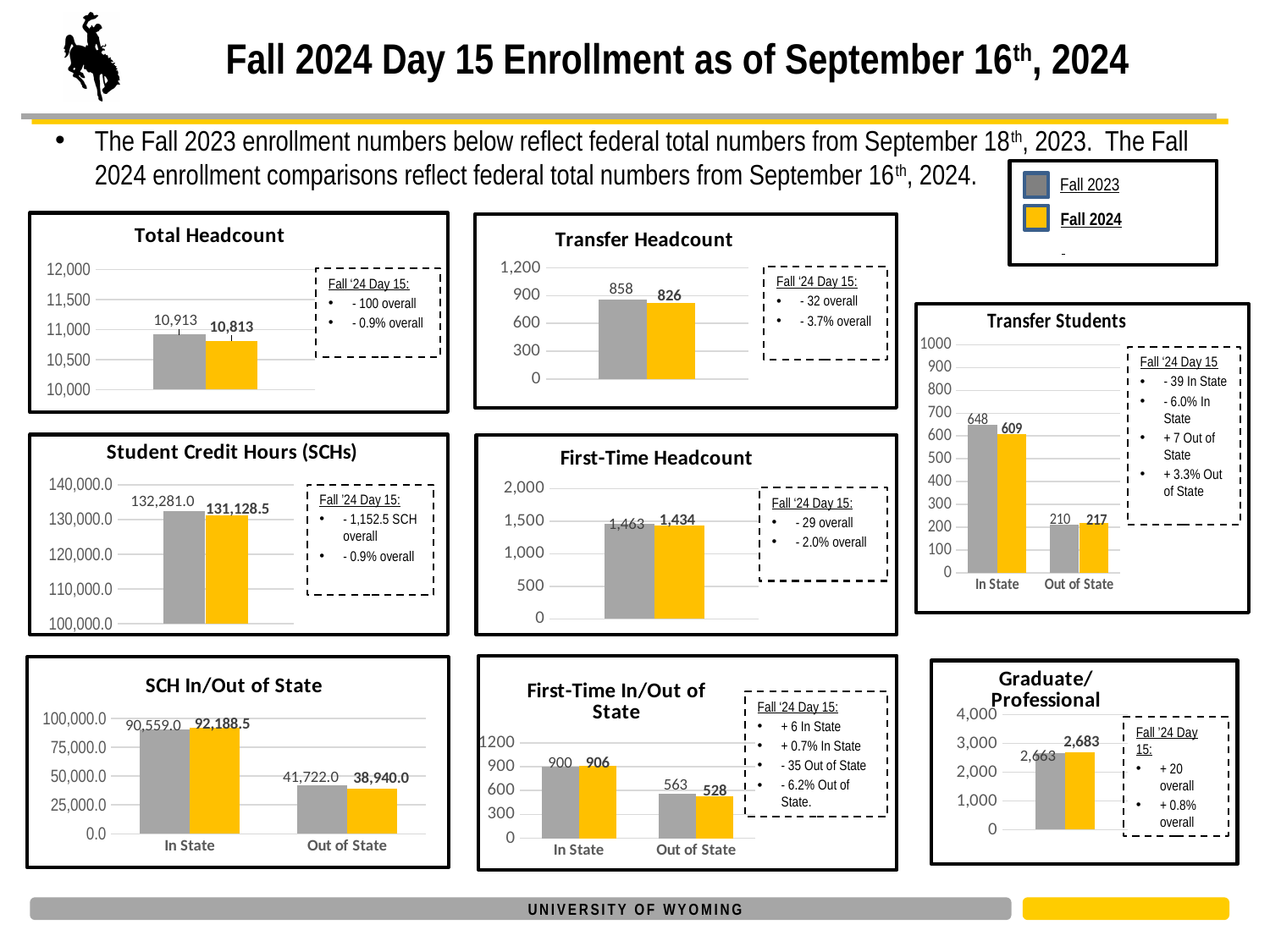
What type of chart is the Total Headcount chart? Bar chart In the SCH In/Out of State chart, what is the Fall 2024 value for In State? 92,188.5 In the Student Credit Hours (SCHs) chart, what is the difference between the Fall 2023 and Fall 2024 values? 1,152.5 In the Transfer Headcount chart, what is the value for Fall 2023? 858 How many series does the legend at the top right of the slide list? 2 In the First-Time Headcount chart, which is larger, the Fall 2023 value or the Fall 2024 value? Fall 2023 In the Transfer Students chart, what is the Fall 2024 value for Out of State? 217 In the Graduate/Professional chart, which is larger, the Fall 2023 value or the Fall 2024 value? Fall 2024 How many categories are shown on the x axis of the SCH In/Out of State chart? 2 In the Transfer Students chart, which category has the highest value? In State In the Total Headcount chart, what is the value for Fall 2024? 10,813 In the First-Time In/Out of State chart, what is the difference between the Fall 2023 and Fall 2024 values for Out of State? 35